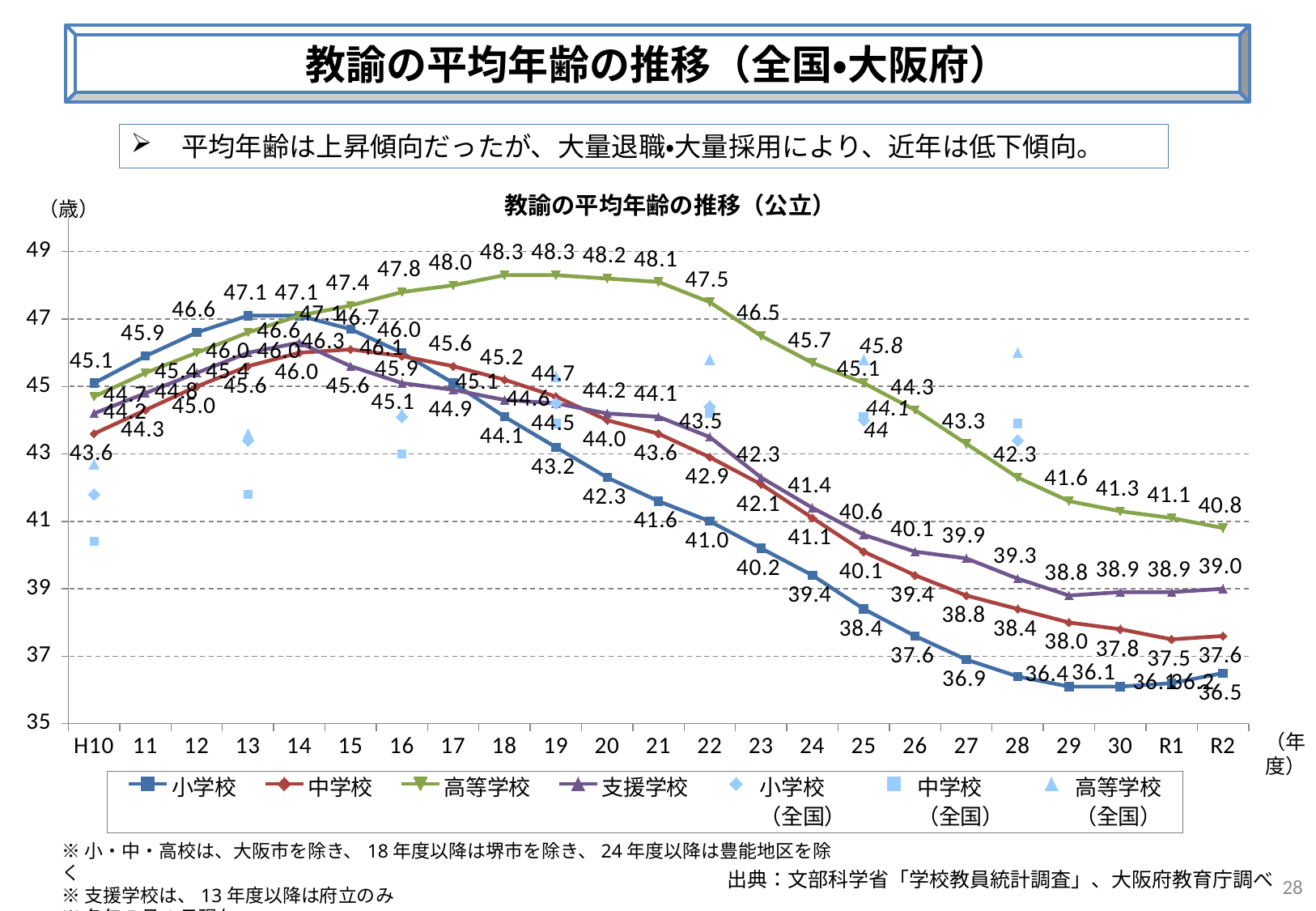
Which series has the highest value in R2? 高等学校 How many year points are shown along the x axis? 23 What is the value for 小学校 in R2? 36.5 What kind of chart is shown on the slide? line chart How many series does the legend list? 7 Does the 高等学校 line rise or fall from year 22 to R2? fall What is the value for 高等学校 in R2? 40.8 What is the value for 高等学校 in year 18? 48.3 What is the value for 小学校 in H10? 45.1 What is the difference between the 高等学校 value and the 小学校 value in R2? 4.3 Is the value for 小学校 in year 25 greater or less than 39? less What is the title of the chart? 教諭の平均年齢の推移（公立）